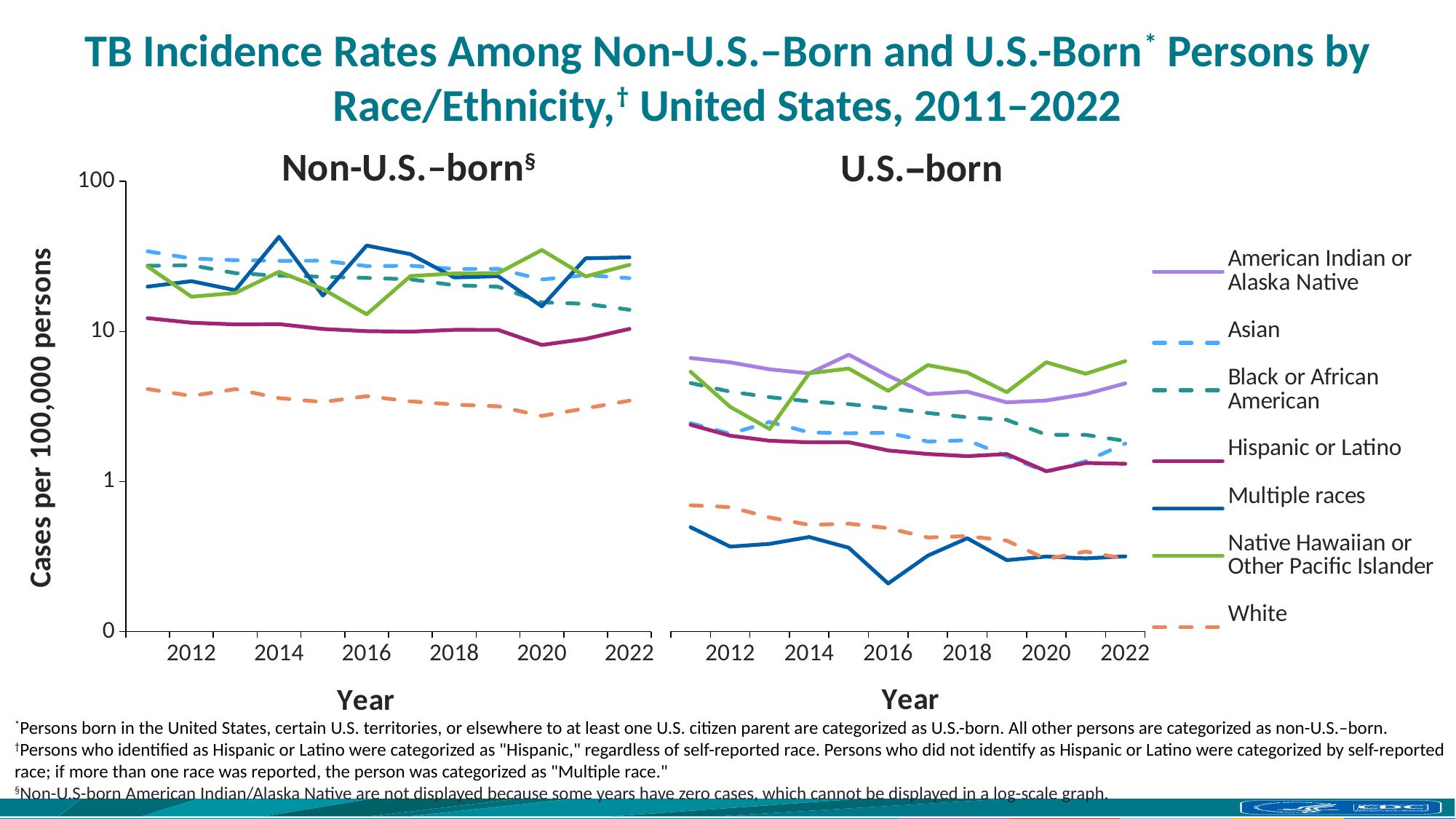
In the Non-U.S.-born chart, is the value for White in 2022 greater or less than 10? less In the U.S.-born chart, which series has the highest value in 2022? Native Hawaiian or Other Pacific Islander In the U.S.-born chart, which series has the lowest value in 2016? Multiple races In the Non-U.S.-born chart, which series has the lowest values across all years? White In the U.S.-born chart, does the White series rise or fall from 2011 to 2022? Fall What is the label on the y axis? Cases per 100,000 persons How many series does the legend list? 7 In the U.S.-born chart, is the value for White in 2022 greater or less than 1? less In the Non-U.S.-born chart, how many years are plotted along the x axis? 12 What kind of chart is used on this slide? Line chart In the Non-U.S.-born chart, is the value for Asian in 2012 greater or less than 10? greater